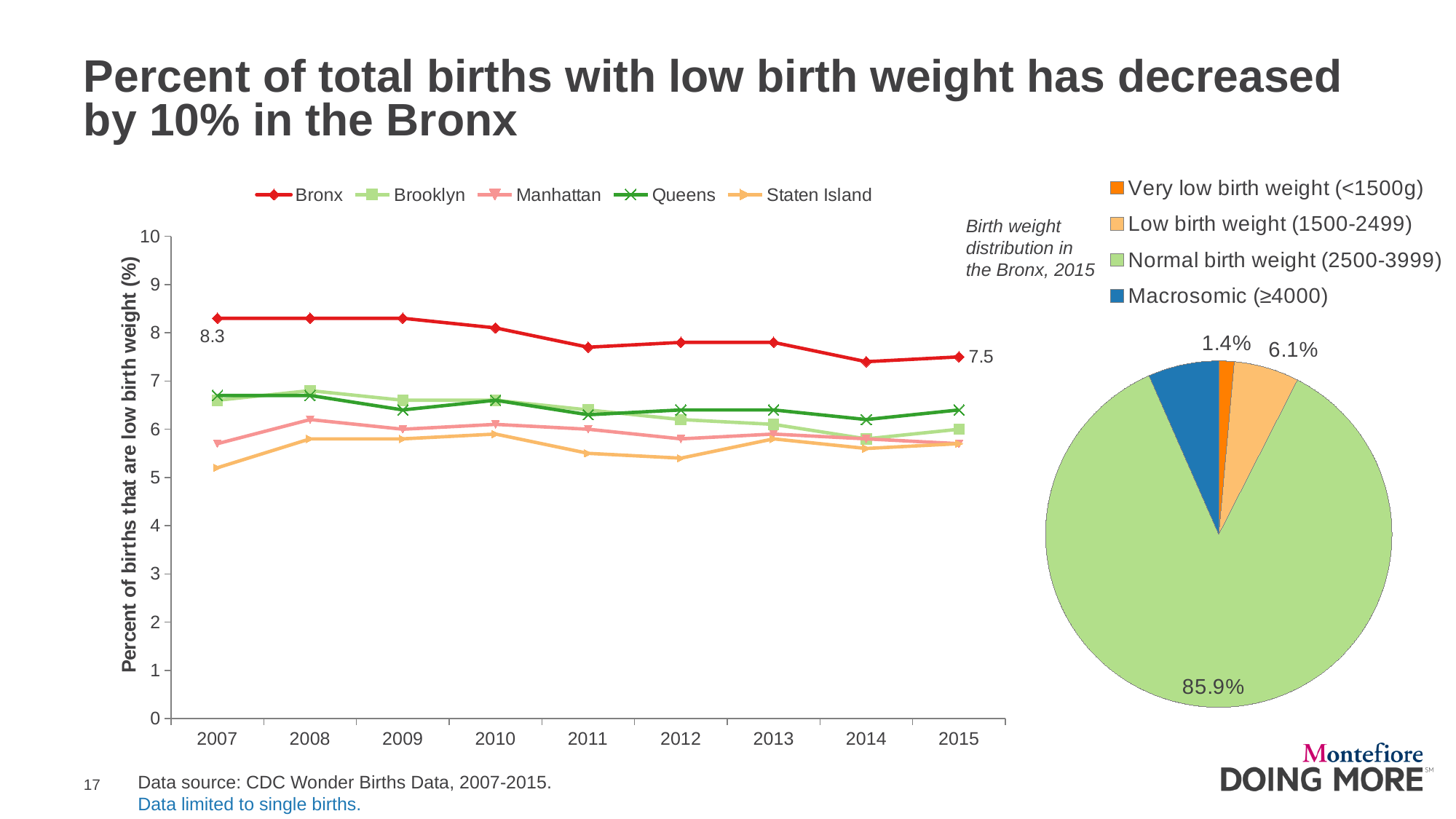
In the line chart, by how much did the Bronx value fall from 2007 to 2015? 0.8 In the line chart, is the value for Staten Island in 2007 greater or less than 6? less In the pie chart of birth weight distribution in the Bronx, 2015, what share is Very low birth weight (<1500g)? 1.4% In the line chart, does the Bronx line rise or fall from 2007 to 2015? fall In the line chart, which borough has the highest percent of low birth weight births across all years? Bronx In the line chart, what was the percent of births with low birth weight in the Bronx in 2007? 8.3 How many years are shown on the x axis of the line chart? 9 In the pie chart, which is larger: Low birth weight (1500-2499) or Very low birth weight (<1500g)? Low birth weight (1500-2499) How many boroughs (series) does the legend of the line chart list? 5 What kind of chart is the chart on the left of the slide? line chart In the pie chart of birth weight distribution in the Bronx, 2015, what share is Normal birth weight (2500-3999)? 85.9% In the line chart, what was the percent of births with low birth weight in the Bronx in 2015? 7.5